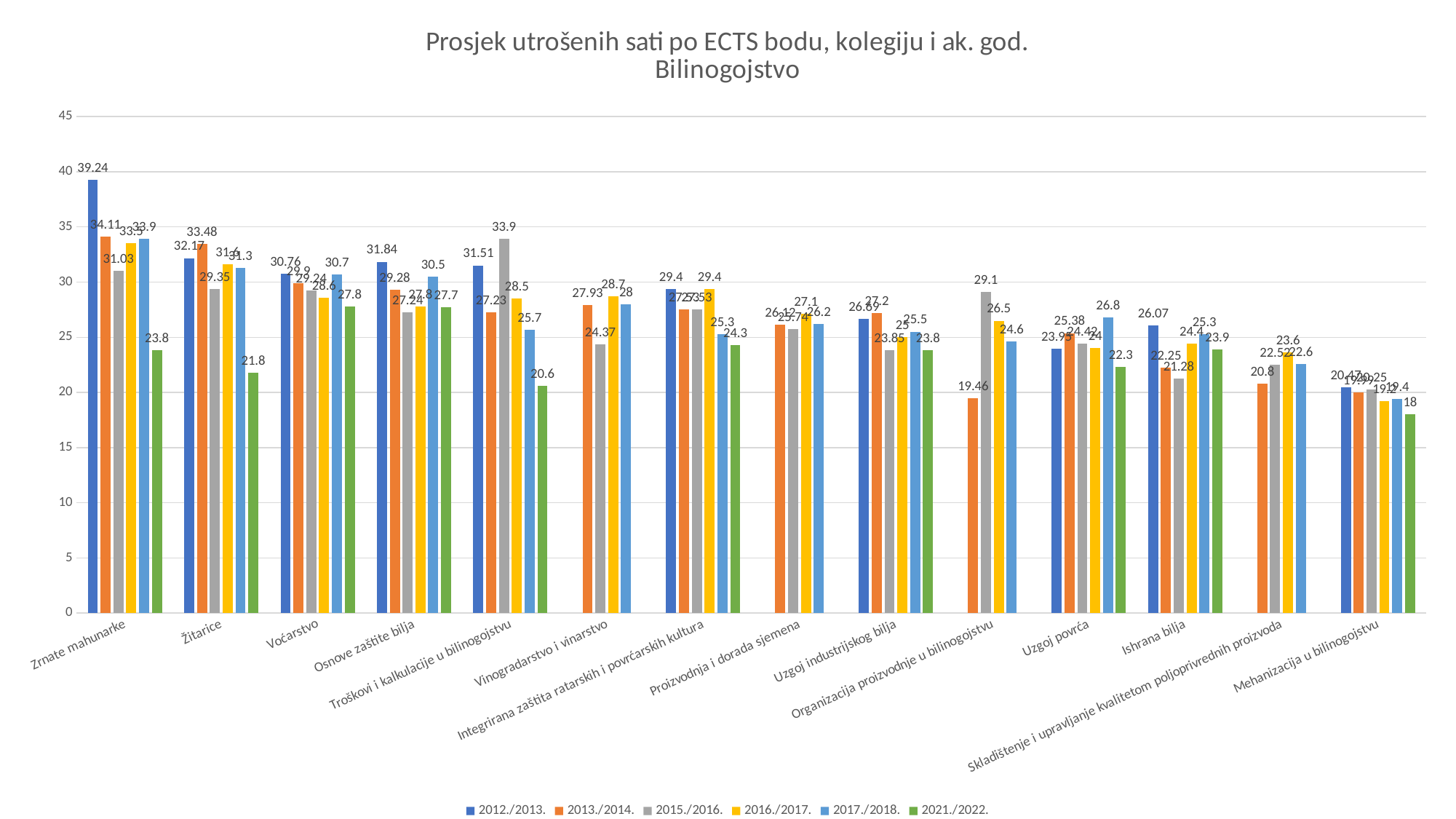
How many series does the legend list? 6 What is the difference between the 2012./2013. and 2021./2022. values for Zrnate mahunarke? 15.44 Which is larger for Žitarice: the 2013./2014. value or the 2021./2022. value? 2013./2014. What is the value for Zrnate mahunarke in the 2012./2013. series? 39.24 What is the value for Mehanizacija u bilinogojstvu in the 2021./2022. series? 18 How many categories are shown on the x axis? 14 What kind of chart is shown on the slide? Bar chart Is the 2015./2016. value for Organizacija proizvodnje u bilinogojstvu greater or less than 25? greater What is the value for Organizacija proizvodnje u bilinogojstvu in the 2013./2014. series? 19.46 Which series has the lowest value for Troškovi i kalkulacije u bilinogojstvu? 2021./2022. What is the value for Troškovi i kalkulacije u bilinogojstvu in the 2015./2016. series? 33.9 Which category has the highest value in the 2012./2013. series? Zrnate mahunarke